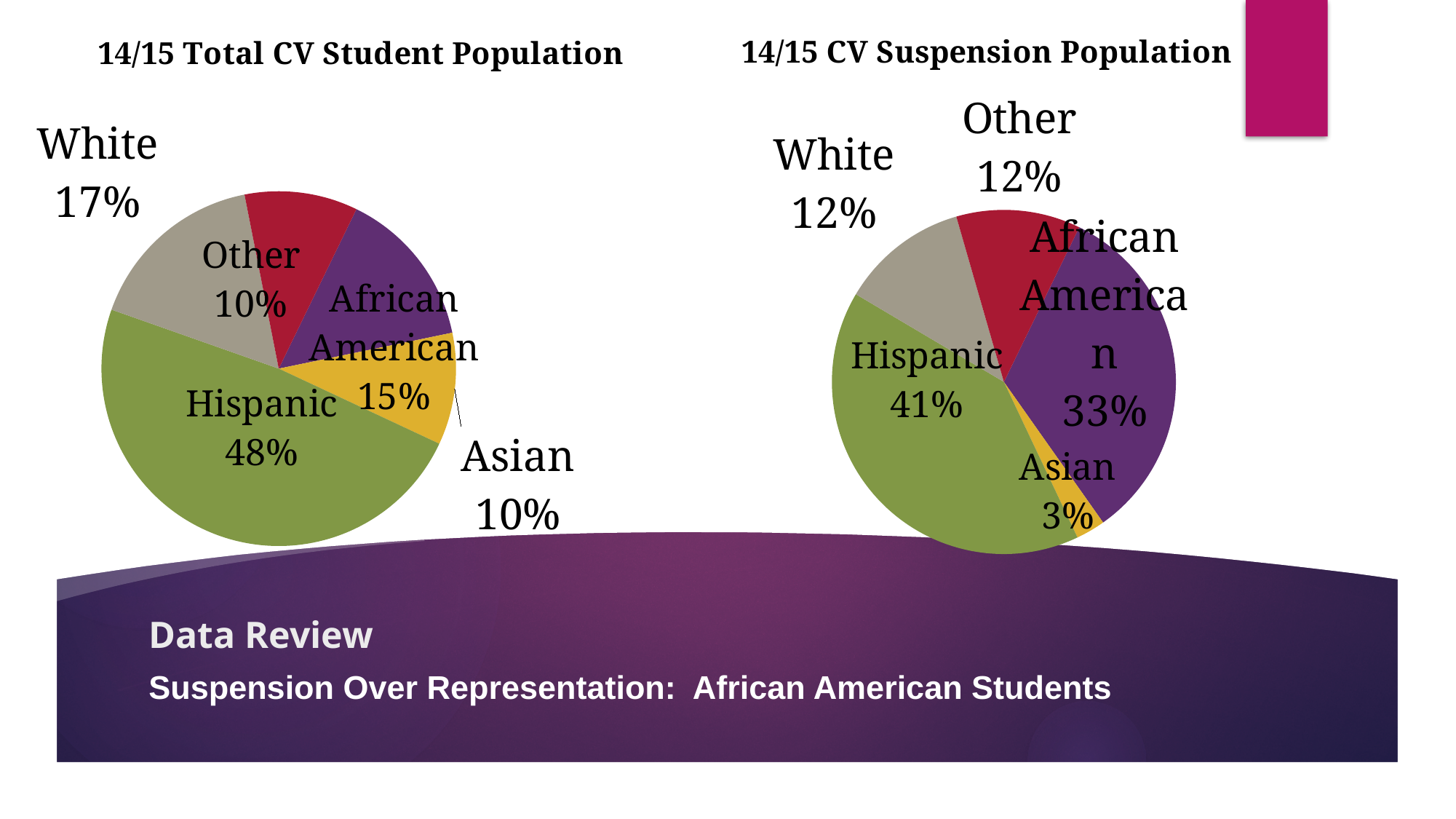
In the '14/15 Total CV Student Population' chart, what share of the pie is Hispanic? 48% In the '14/15 CV Suspension Population' chart, what is the value for White? 12% In the '14/15 Total CV Student Population' chart, which is larger, the White slice or the Other slice? White What type of chart is the '14/15 Total CV Student Population' chart? Pie chart How many categories are shown in the '14/15 CV Suspension Population' chart? 5 In the '14/15 Total CV Student Population' chart, which category has the largest slice? Hispanic What is the difference between the African American share in the '14/15 CV Suspension Population' chart and the African American share in the '14/15 Total CV Student Population' chart? 18 percentage points In the '14/15 CV Suspension Population' chart, what share of the pie is African American? 33% In the '14/15 Total CV Student Population' chart, what is the value for African American? 15% What is the title of the chart on the right side of the slide? 14/15 CV Suspension Population In the '14/15 CV Suspension Population' chart, which category has the smallest slice? Asian In the '14/15 CV Suspension Population' chart, what is the value for Asian? 3%